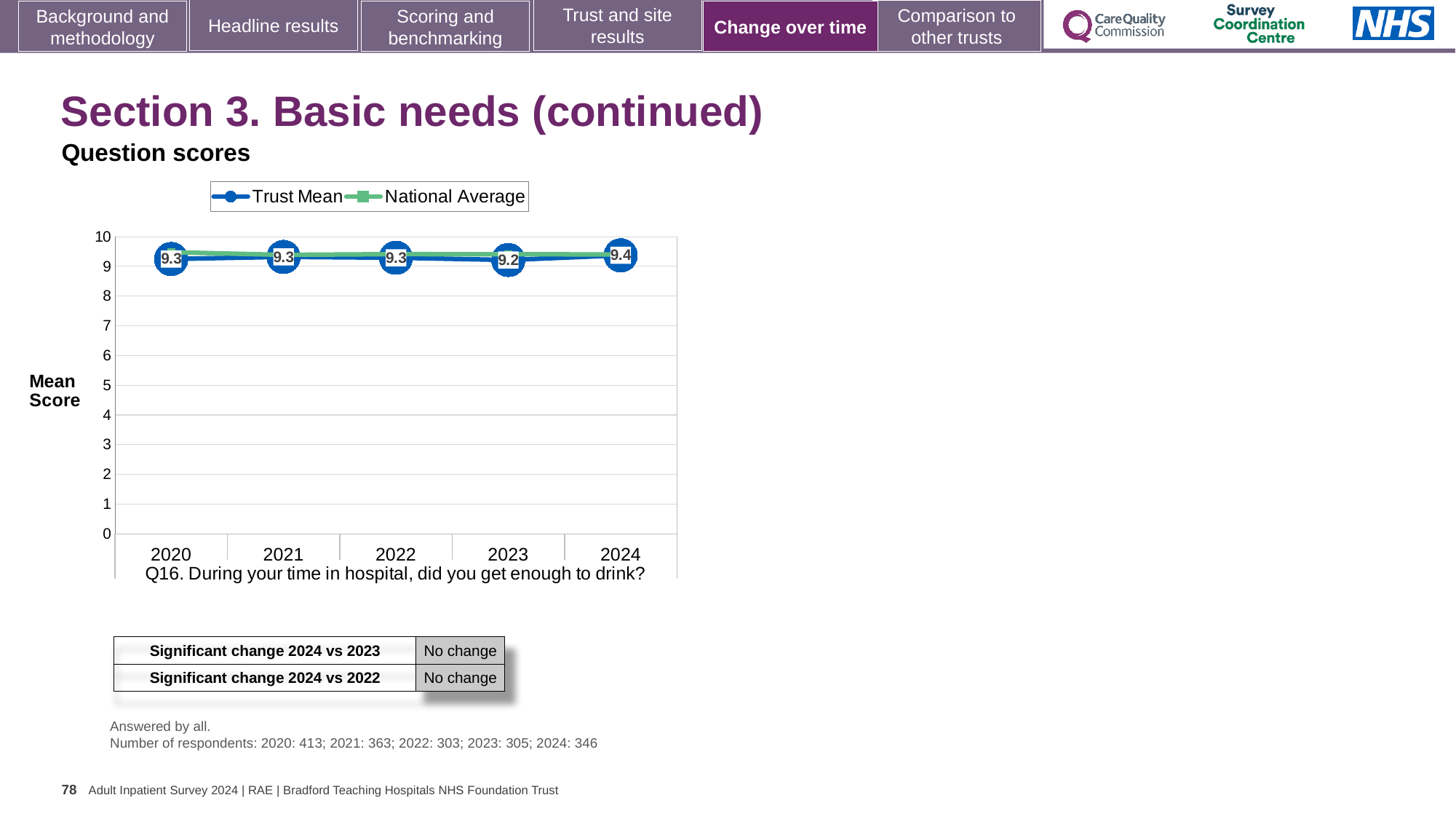
Which year has the larger Trust Mean score, 2023 or 2024? 2024 How many series does the chart legend list? 2 In which year is the Trust Mean score lowest? 2023 How many years are plotted on the x axis of the chart? 5 What is the Trust Mean score for 2020? 9.3 What is the difference between the Trust Mean score in 2024 and in 2023? 0.2 Is the National Average value for 2022 greater or less than 8? greater In which year is the Trust Mean score highest? 2024 What is the Trust Mean score for 2024? 9.4 Which survey question does the chart show scores for? Q16. During your time in hospital, did you get enough to drink? What kind of chart is shown on the slide? Line chart What is the Trust Mean score for 2023? 9.2